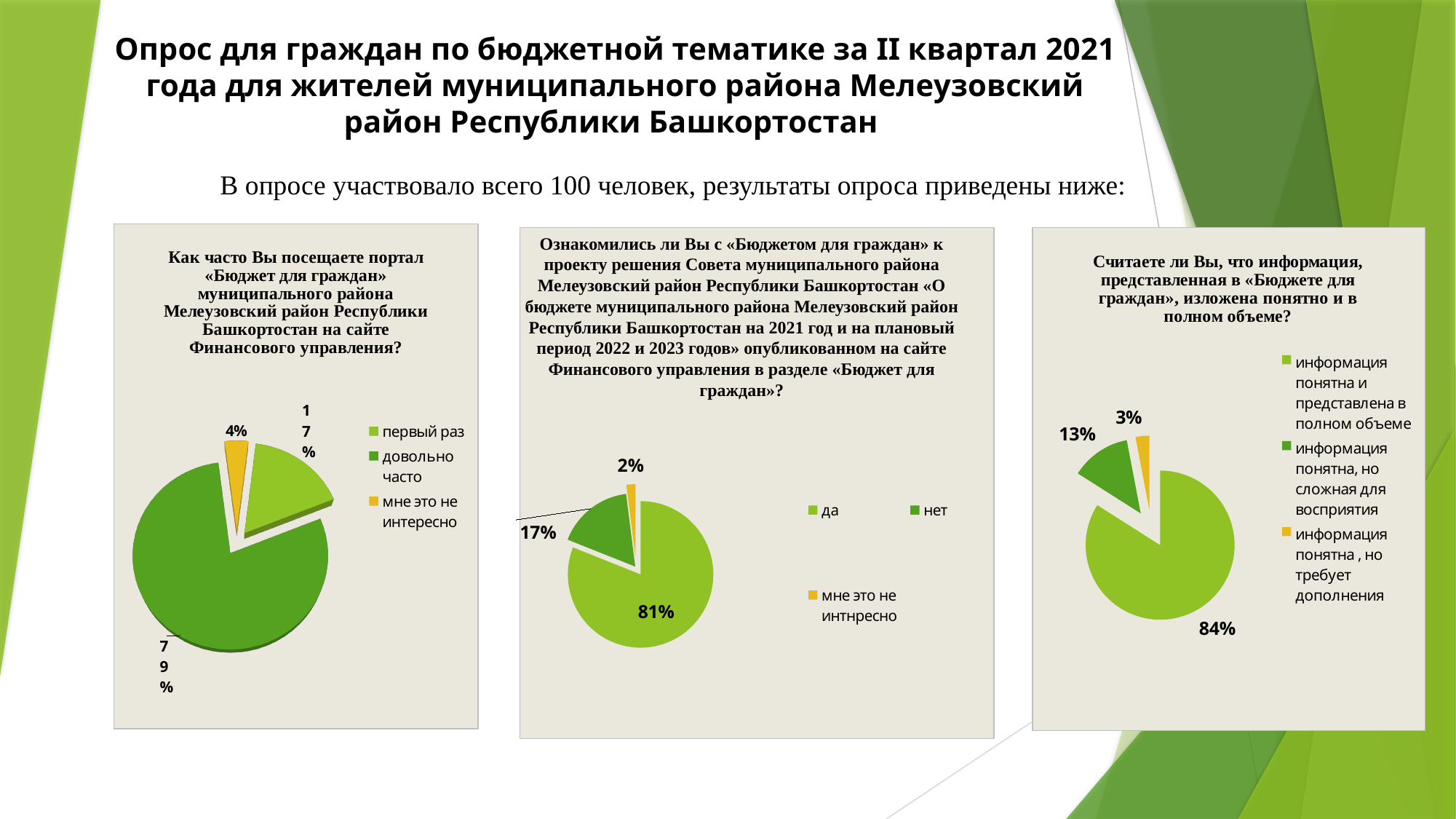
In the left pie chart (how often do you visit the portal), what share of respondents answered «довольно часто»? 79% In the left pie chart, what percentage answered «первый раз»? 17% In the middle pie chart, which answer has the largest share? да In the right pie chart, what share chose «информация понятна, но сложная для восприятия»? 13% What type of chart is used for all three charts on the slide? pie chart In the left pie chart, what is the difference between the «довольно часто» and «первый раз» shares? 62% In the middle pie chart, what share answered «нет»? 17% In the left pie chart, which answer has the smallest share? мне это не интересно In the middle pie chart (have you read the «Бюджет для граждан»), what share answered «да»? 81% In the right pie chart (is the information clear and complete), what share chose «информация понятна и представлена в полном объеме»? 84% In the right pie chart, which is larger: «информация понятна, но сложная для восприятия» or «информация понятна, но требует дополнения»? информация понятна, но сложная для восприятия How many categories does the legend of the middle pie chart list? 3